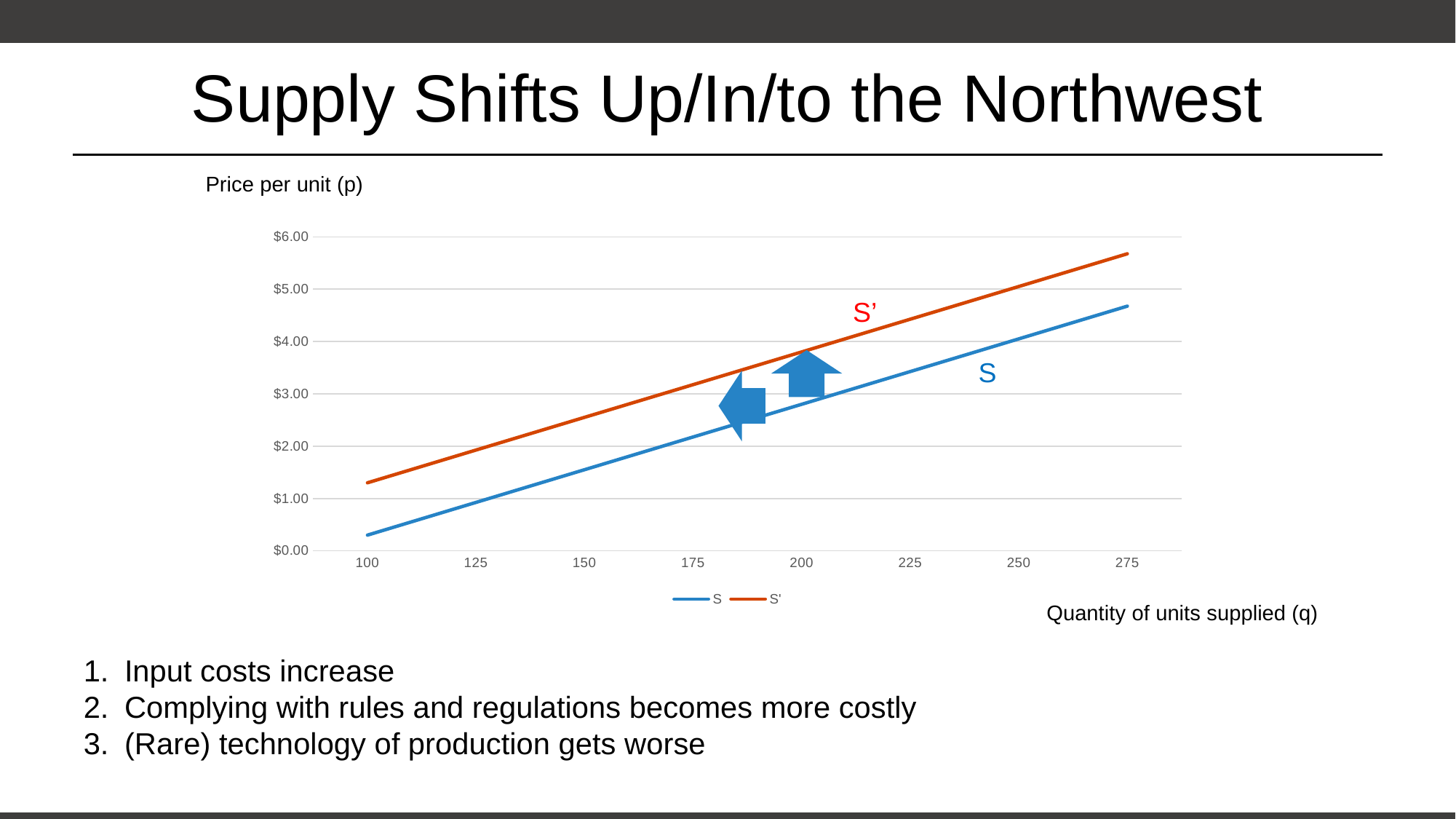
Is the price on the S line at a quantity of 275 greater or less than $4.00? greater How many series does the legend list? 2 What kind of chart is shown on the slide? line chart Is the price on the S' line at a quantity of 275 greater or less than $5.00? greater Is the price on the S line at a quantity of 100 greater or less than $1.00? less What are the two series named in the legend? S and S' Do the values of the S line rise or fall as quantity increases along the x axis? rise How many quantity values are marked along the x axis? 8 At a quantity of 200, which line has the higher price, S or S'? S' Do the values of the S' line rise or fall as quantity increases along the x axis? rise What is the label of the vertical axis of the chart? Price per unit (p)